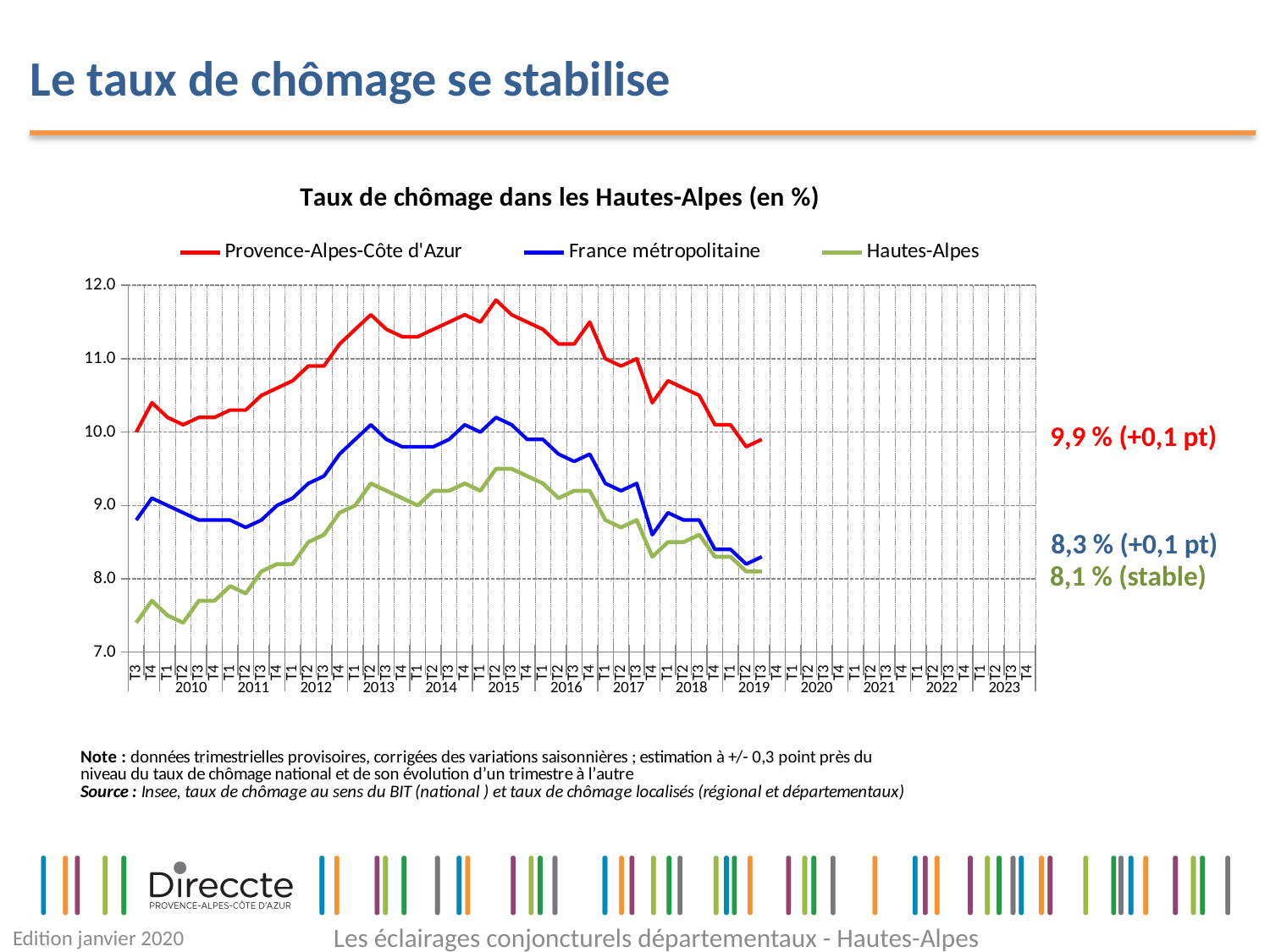
What is the latest unemployment rate shown for France métropolitaine? 8,3 % How many series does the legend list? 3 What kind of chart is shown on the slide? line chart Is the value for Hautes-Alpes in T3 2009 greater or less than 8.0? less Which series has the highest value at the end of the plotted period? Provence-Alpes-Côte d'Azur What is the latest unemployment rate shown for Hautes-Alpes? 8,1 % Is the value for Provence-Alpes-Côte d'Azur in T2 2013 greater or less than 11.0? greater What is the title of the chart? Taux de chômage dans les Hautes-Alpes (en %) Which series has the lowest values across the whole plotted period? Hautes-Alpes Do the values for France métropolitaine rise or fall between 2015 and 2019? fall What is the latest unemployment rate shown for Provence-Alpes-Côte d'Azur? 9,9 % What is the difference between the latest rates for Provence-Alpes-Côte d'Azur and Hautes-Alpes? 1,8 points